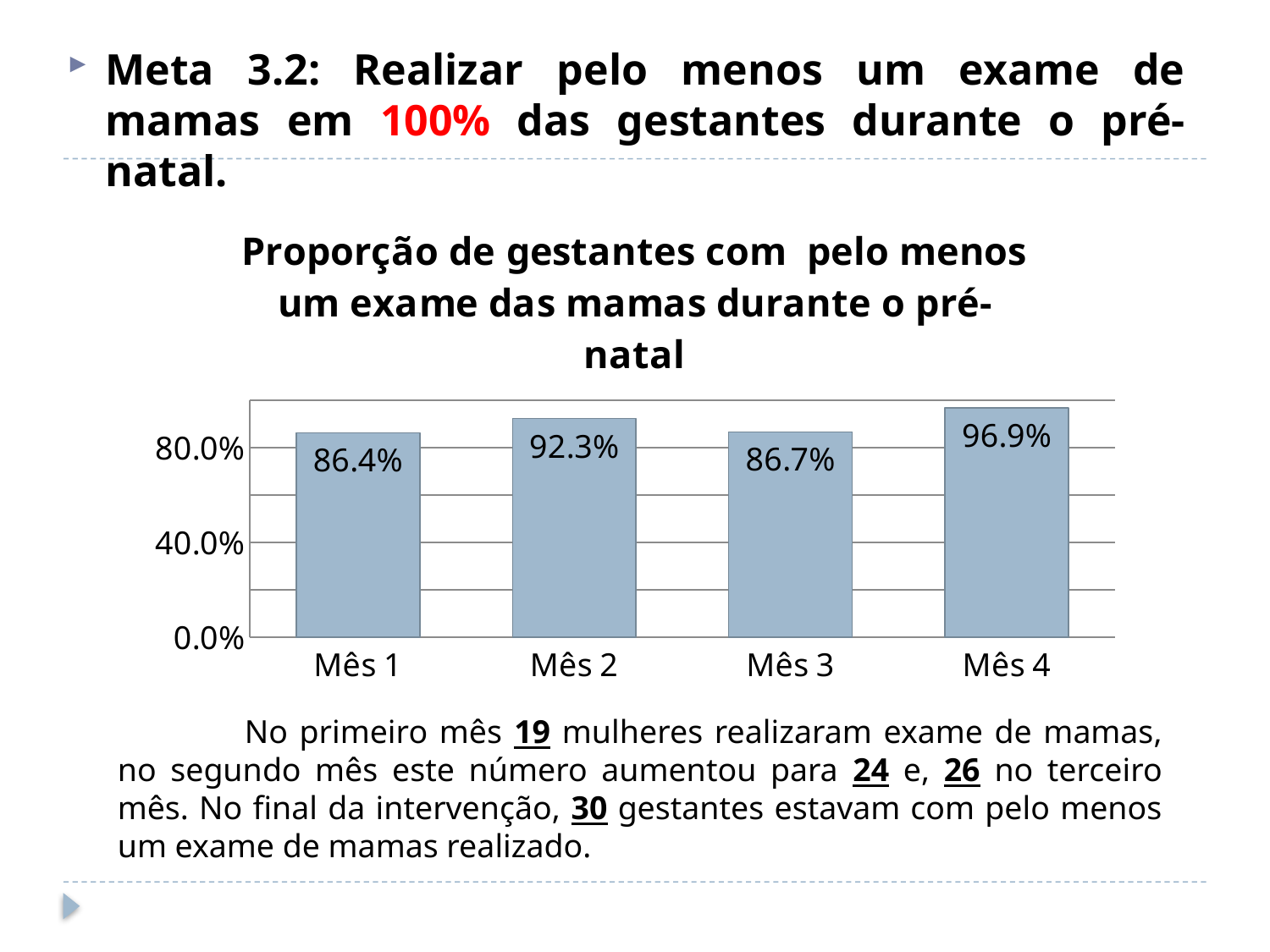
What is the value for Mês 4? 96.9% What is the value for Mês 1? 86.4% Is the value for Mês 3 greater or less than 80.0%? greater How many months are shown on the chart? 4 What is the difference between the values for Mês 4 and Mês 1? 10.5% What is the value for Mês 2? 92.3% What is the value for Mês 3? 86.7% What is the difference between the values for Mês 2 and Mês 3? 5.6% Which is larger, the value for Mês 2 or the value for Mês 3? Mês 2 Which month has the lowest value? Mês 1 What kind of chart is shown on the slide? bar chart Which month has the highest value? Mês 4